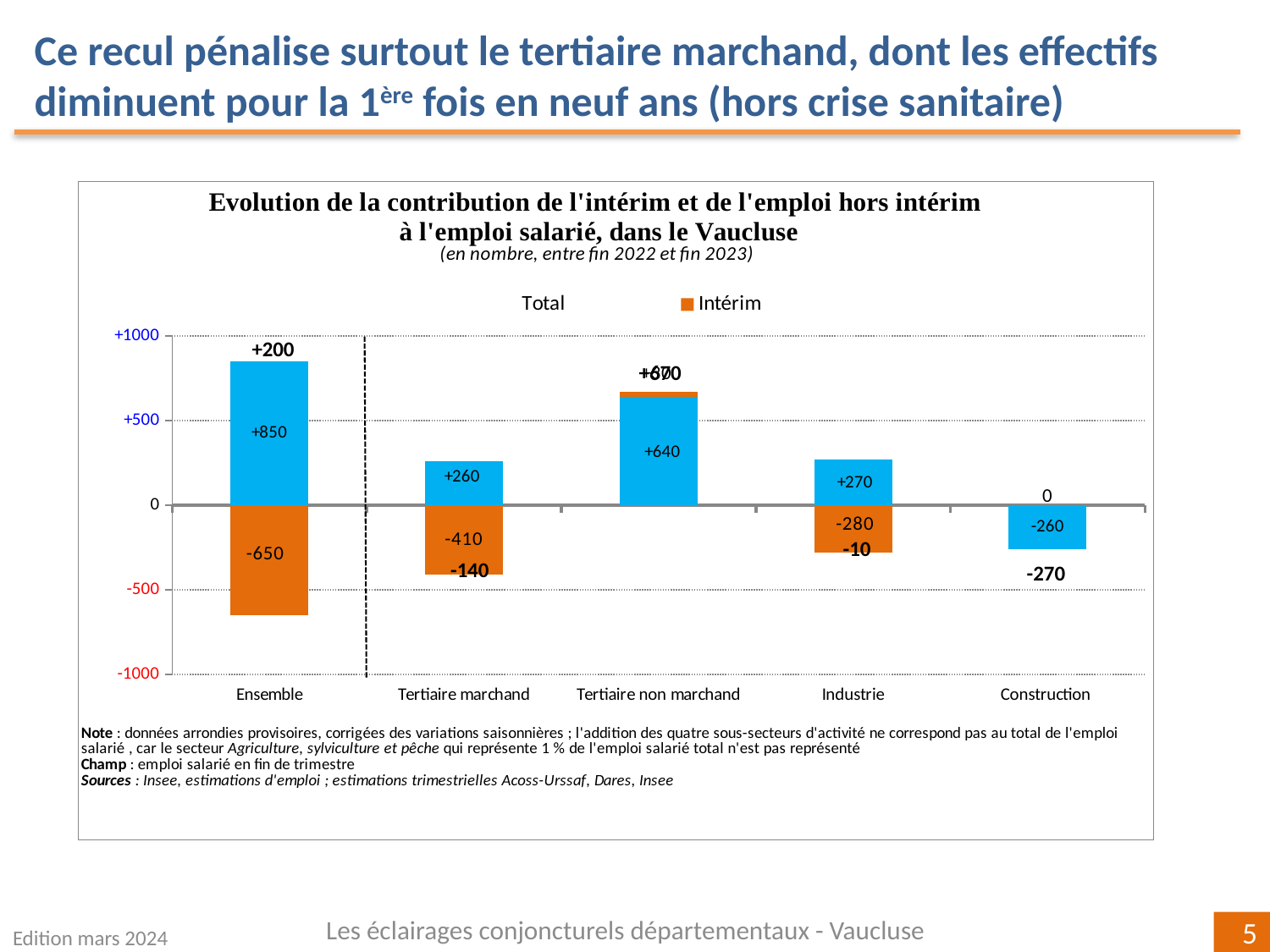
What is the value of the blue bar for Tertiaire non marchand? +640 What is the Intérim value for Ensemble? -650 How many entries does the legend list? 2 Which colour represents the Intérim series in the legend? orange What is the value of the blue bar for Ensemble? +850 How many sector categories are shown on the x axis? 5 What is the difference between the Intérim values for Ensemble and Tertiaire marchand? 240 What kind of chart is this? bar chart Which category has the lowest Total value? Construction What is the Intérim value for Industrie? -280 What is the Total value shown for Tertiaire marchand? -140 What is the Total value shown for Construction? -270